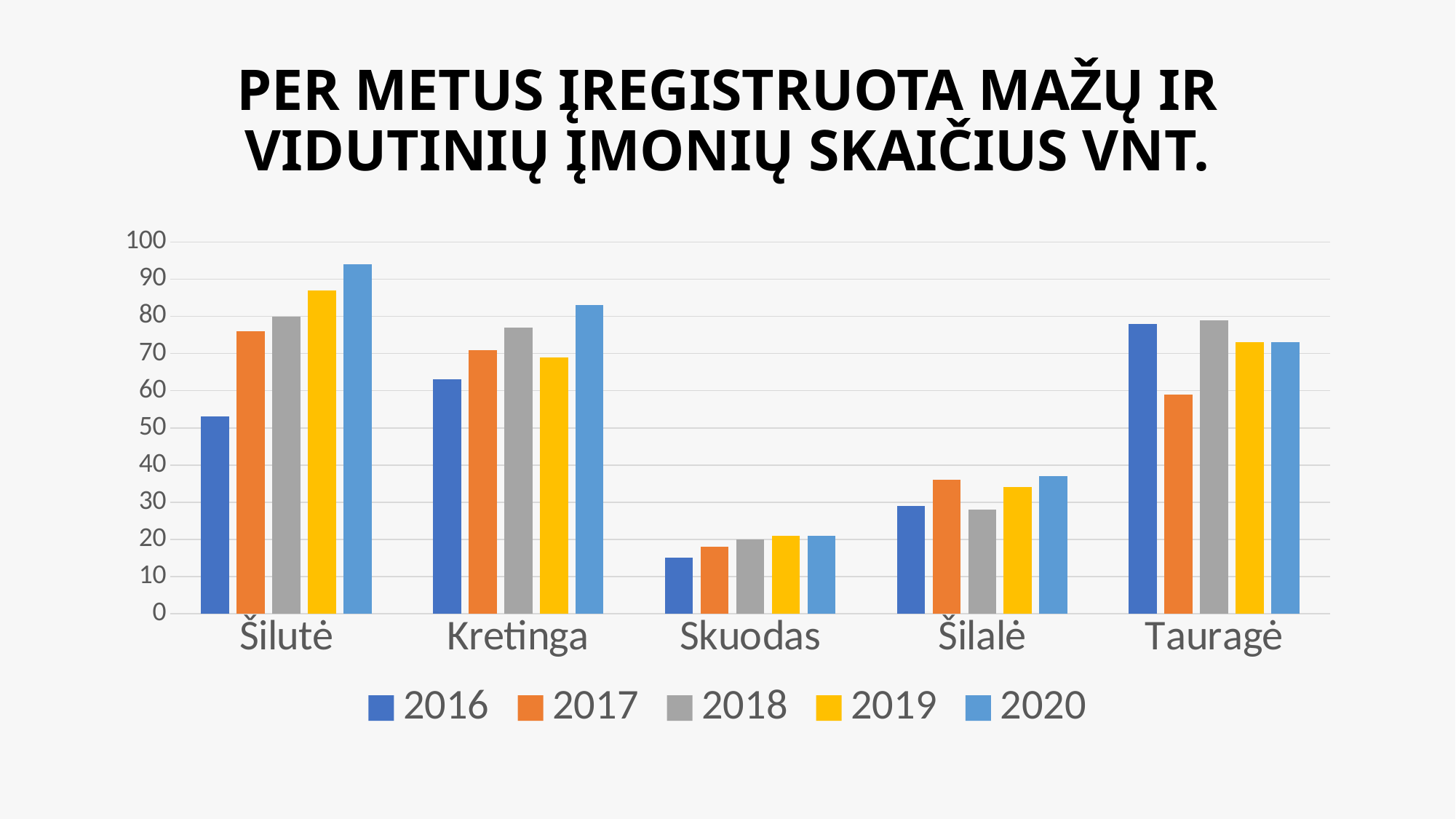
What kind of chart is shown on the slide? bar chart Which is larger: the 2020 value for Šilutė or the 2020 value for Kretinga? Šilutė Which municipality has the highest value for 2020? Šilutė For Tauragė, which is larger: the 2016 value or the 2017 value? 2016 How many categories (municipalities) are shown on the x axis? 5 Is the 2020 value for Šilutė greater or less than 90? greater Is the 2017 value for Šilalė greater or less than 30? greater Is the 2016 value for Skuodas greater or less than 20? less For Šilutė, do the values rise or fall from 2016 to 2020? rise Which municipality has the lowest value for 2016? Skuodas How many series does the legend list? 5 Which colour represents the 2019 series in the legend? yellow